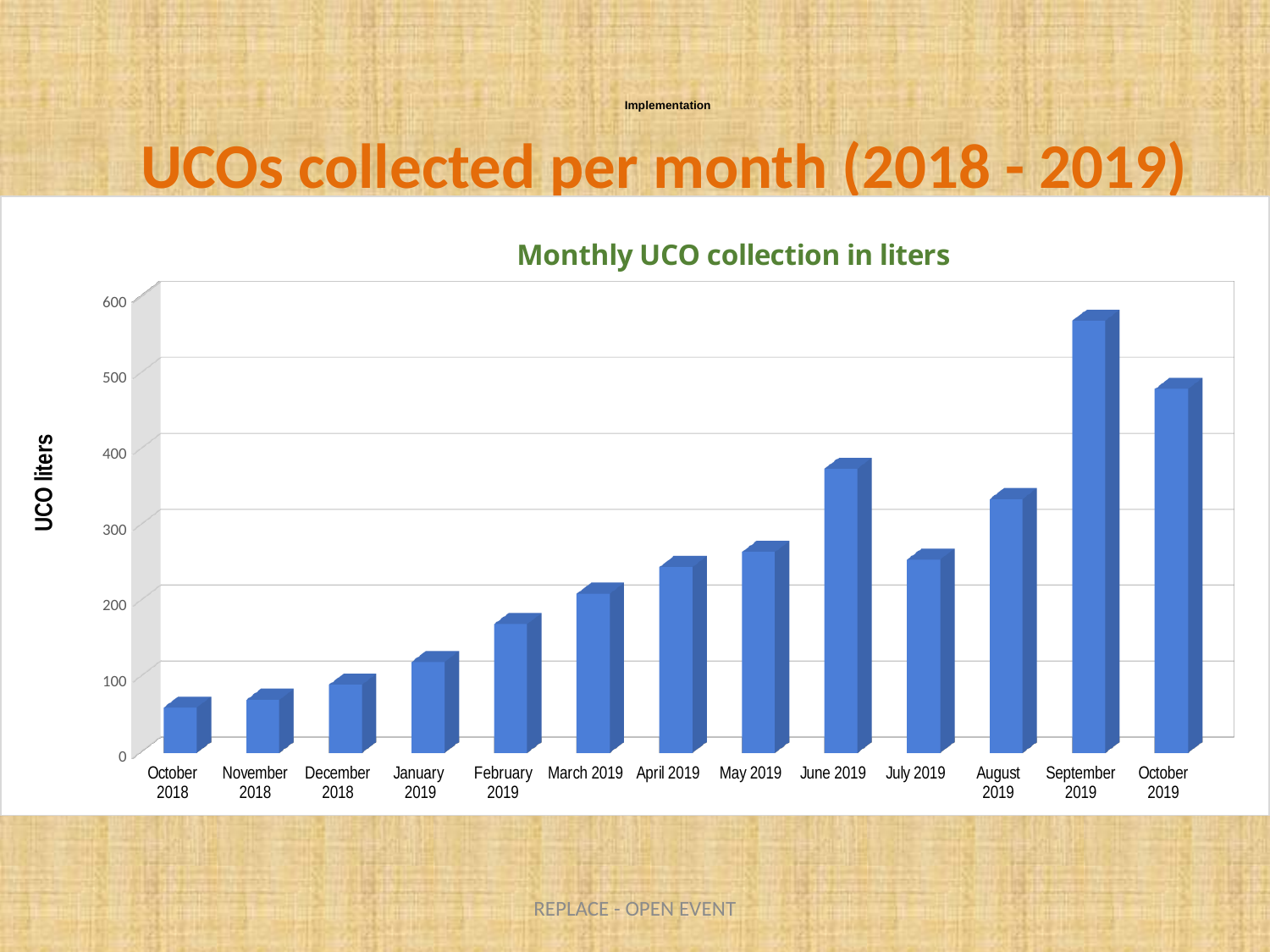
Do the values generally rise or fall from October 2018 to June 2019? rise Is the value for June 2019 greater or less than 400? less What is the label on the vertical axis of the chart? UCO liters Is the value for February 2019 greater or less than 200? less Which is larger, the value for June 2019 or the value for July 2019? June 2019 Is the value for August 2019 greater or less than 300? greater Which month has the highest UCO collection? September 2019 How many months are shown on the x axis of the chart? 13 What kind of chart is shown on the slide? Bar chart What is the title of the chart? Monthly UCO collection in liters